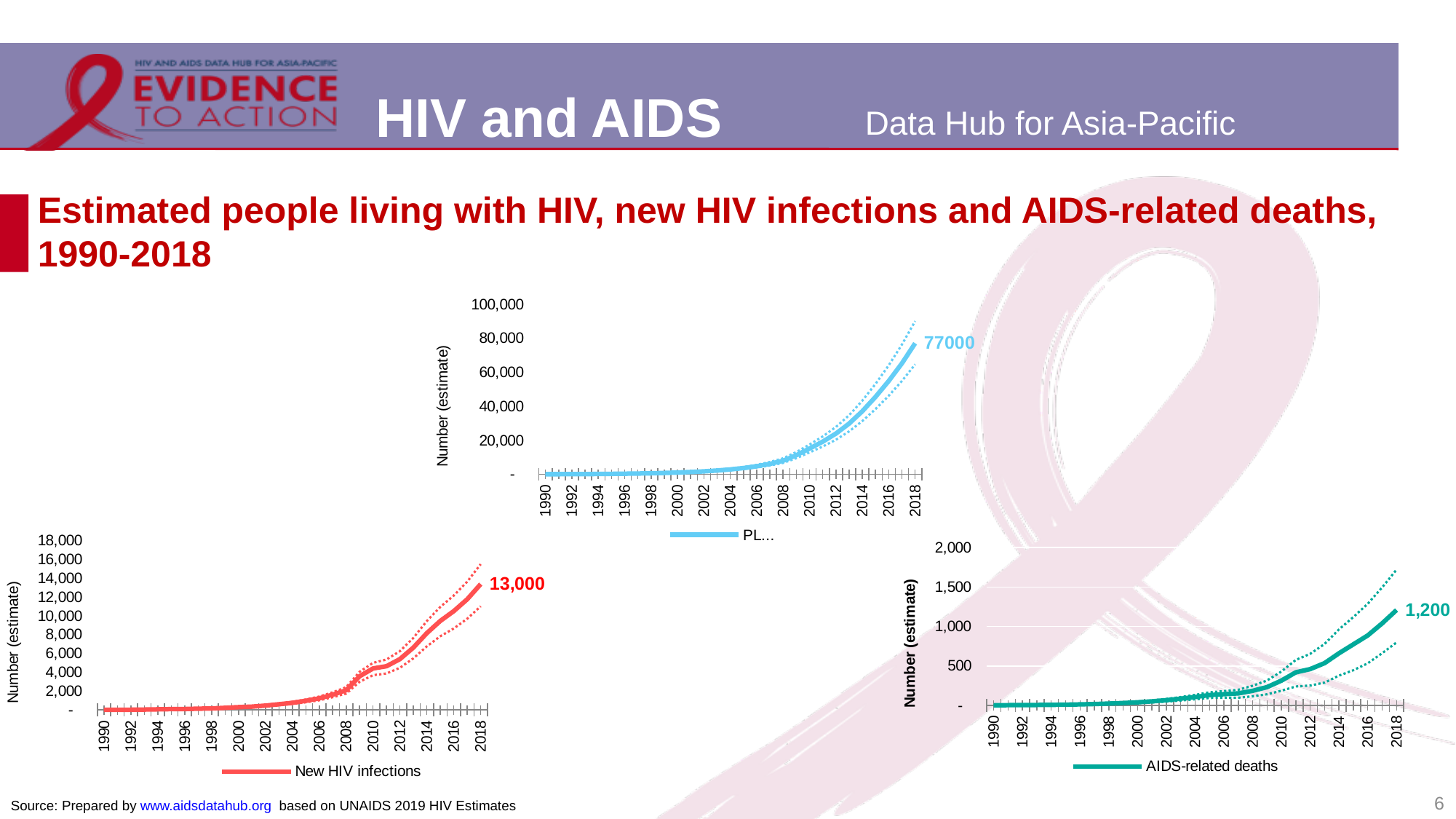
On the bottom-left chart (New HIV infections), do the values rise or fall from 1990 to 2018? rise What is the difference between the 2018 labelled value on the bottom-left chart (New HIV infections, 13,000) and the 2018 labelled value on the bottom-right chart (AIDS-related deaths, 1,200)? 11,800 On the bottom-right chart (AIDS-related deaths), what is the labelled value for 2018? 1,200 On the top chart (people living with HIV), what is the labelled value at the end of the series in 2018? 77000 What kind of chart is the bottom-left chart showing New HIV infections? line chart Which 2018 labelled value is larger: new HIV infections on the bottom-left chart or AIDS-related deaths on the bottom-right chart? New HIV infections On the bottom-left chart (New HIV infections), what is the labelled value for 2018? 13,000 On the bottom-left chart (New HIV infections), is the value for 2010 greater or less than 6,000? less On the bottom-right chart (AIDS-related deaths), is the value for 2016 greater or less than 500? greater On the bottom-right chart (AIDS-related deaths), do the values rise or fall over the period 1990 to 2018? rise What is the legend label of the series on the bottom-right chart? AIDS-related deaths